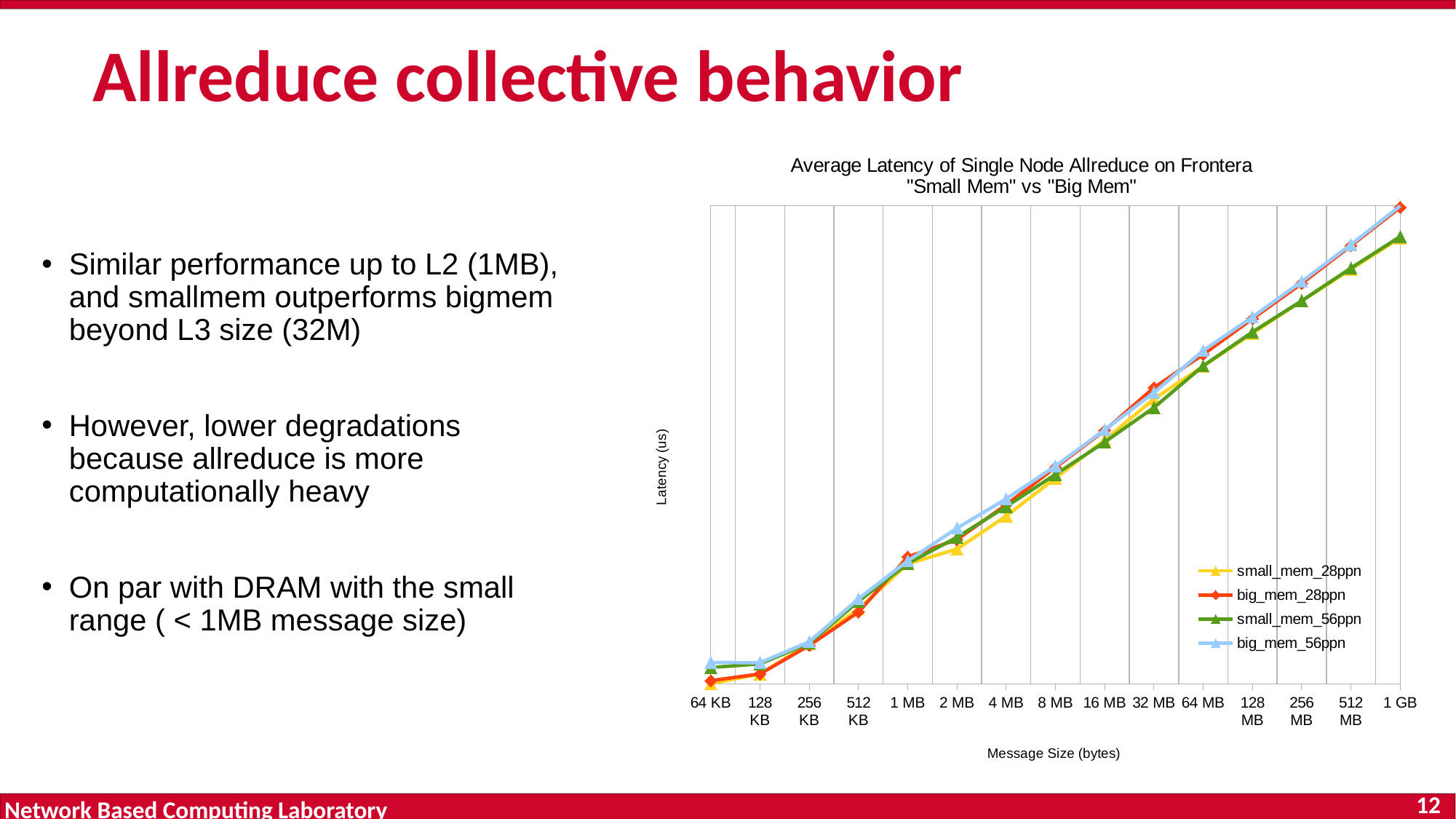
What kind of chart is shown on the slide? line chart Do the latency values rise or fall as message size increases along the x axis? rise How many series does the chart legend list? 4 What is the title of the chart? Average Latency of Single Node Allreduce on Frontera "Small Mem" vs "Big Mem" How many message sizes are plotted along the x axis? 15 At 64 KB, which is larger: the latency for big_mem_56ppn or for big_mem_28ppn? big_mem_56ppn What is the label of the y axis? Latency (us) Which message size is the first category on the x axis? 64 KB At 1 GB, which is larger: the latency for big_mem_28ppn or for small_mem_28ppn? big_mem_28ppn At 512 MB, which is larger: the latency for big_mem_56ppn or for small_mem_56ppn? big_mem_56ppn